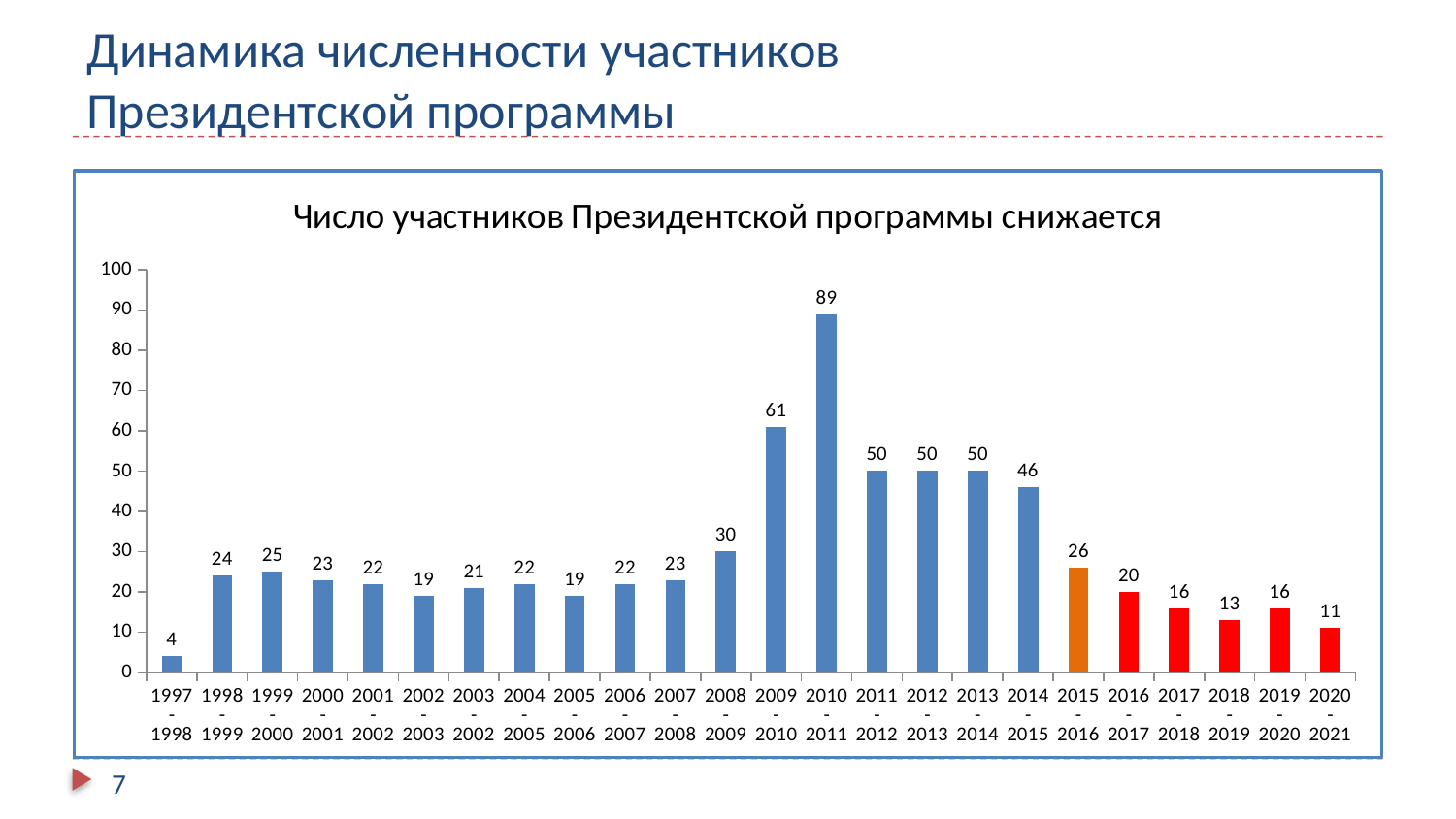
What is the value for 2020-2021? 11 What kind of chart is shown? bar chart How many periods are shown on the x axis? 24 Is the value for 2009-2010 greater or less than 50? greater Which period has the highest value? 2010-2011 What is the value for 1997-1998? 4 What is the difference between the values for 2010-2011 and 2009-2010? 28 Which period has the lowest value? 1997-1998 Which is larger, the value for 2014-2015 or the value for 2015-2016? 2014-2015 What is the value for 2010-2011? 89 What is the title of the chart? Число участников Президентской программы снижается What is the value for 2015-2016? 26